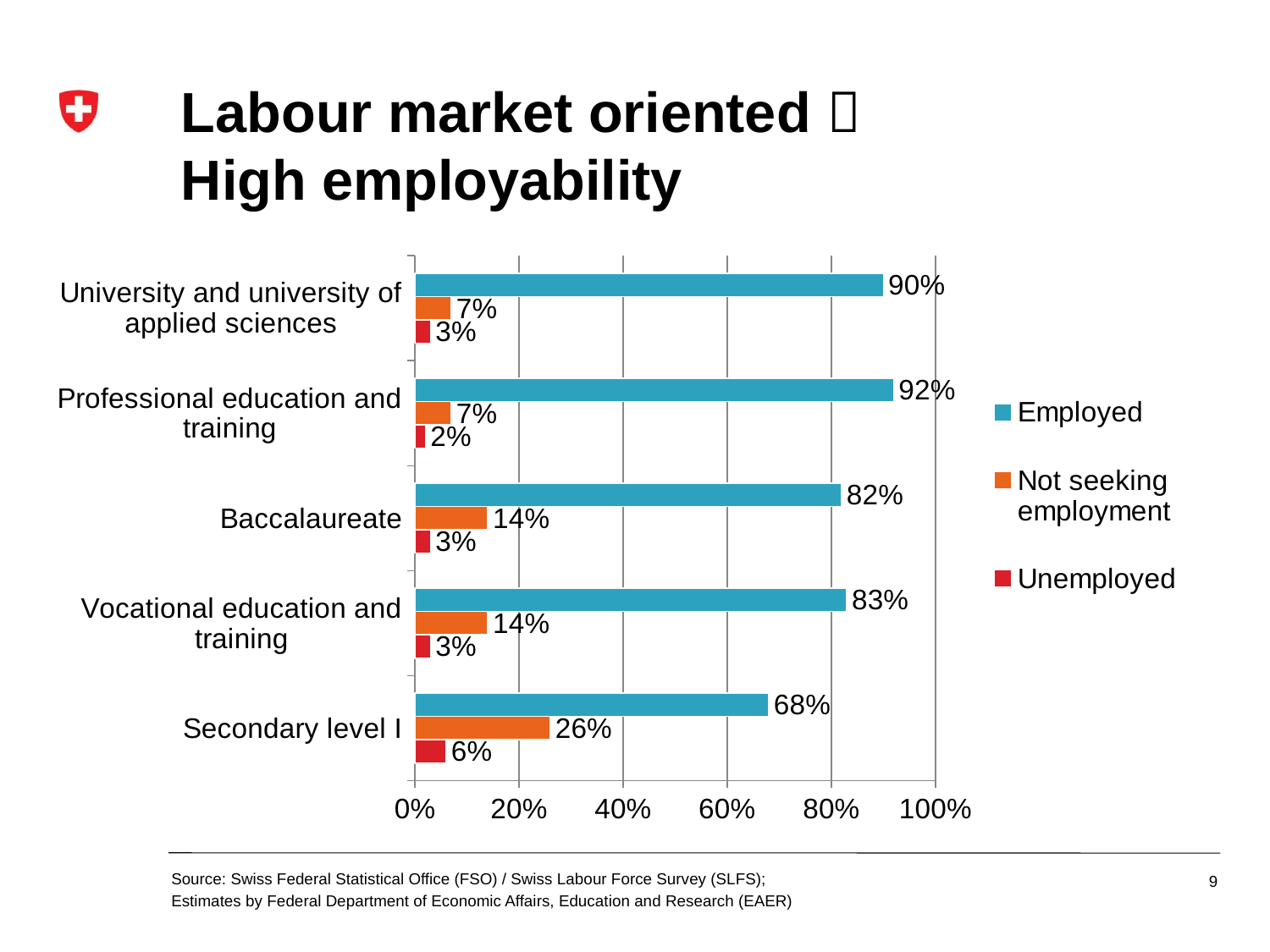
What is the Unemployed value for Professional education and training? 2% What is the Employed value for Secondary level I? 68% How many categories are shown on the chart? 5 Which is larger: the Not seeking employment value for Secondary level I or for Vocational education and training? Secondary level I What kind of chart is shown on the slide? Bar chart Which category has the highest Unemployed value? Secondary level I How many series does the legend list? 3 What is the Not seeking employment value for Baccalaureate? 14% Which series is shown in red in the legend? Unemployed Which category has the lowest Employed value? Secondary level I What is the difference between the Employed values for Professional education and training and Secondary level I? 24% Which category has the highest Employed value? Professional education and training